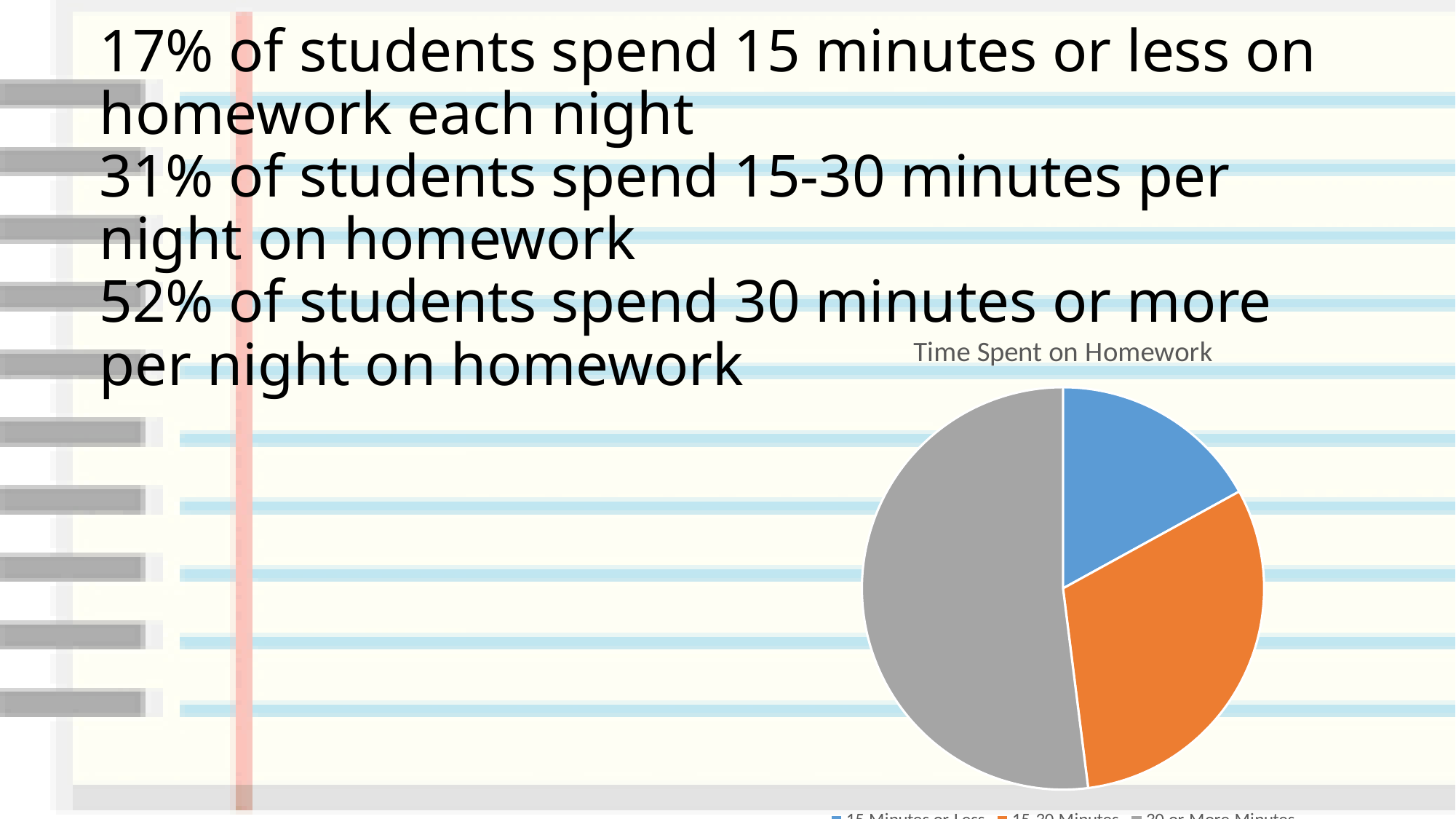
According to the slide, what share of students spend 30 minutes or more per night on homework? 52% What is the title of the chart? Time Spent on Homework How many entries does the chart legend list? 3 Which slice is larger, 15-30 Minutes or 15 Minutes or Less? 15-30 Minutes How many slices does the pie chart have? 3 According to the slide, what share of students spend 15 minutes or less on homework each night? 17% Which slice is larger, 30 or More Minutes or 15-30 Minutes? 30 or More Minutes Which category has the largest slice of the pie? 30 or More Minutes Which category has the smallest slice of the pie? 15 Minutes or Less What kind of chart is shown on the slide? pie chart According to the slide, what share of students spend 15-30 minutes per night on homework? 31% What colour is the slice for 30 or More Minutes? gray